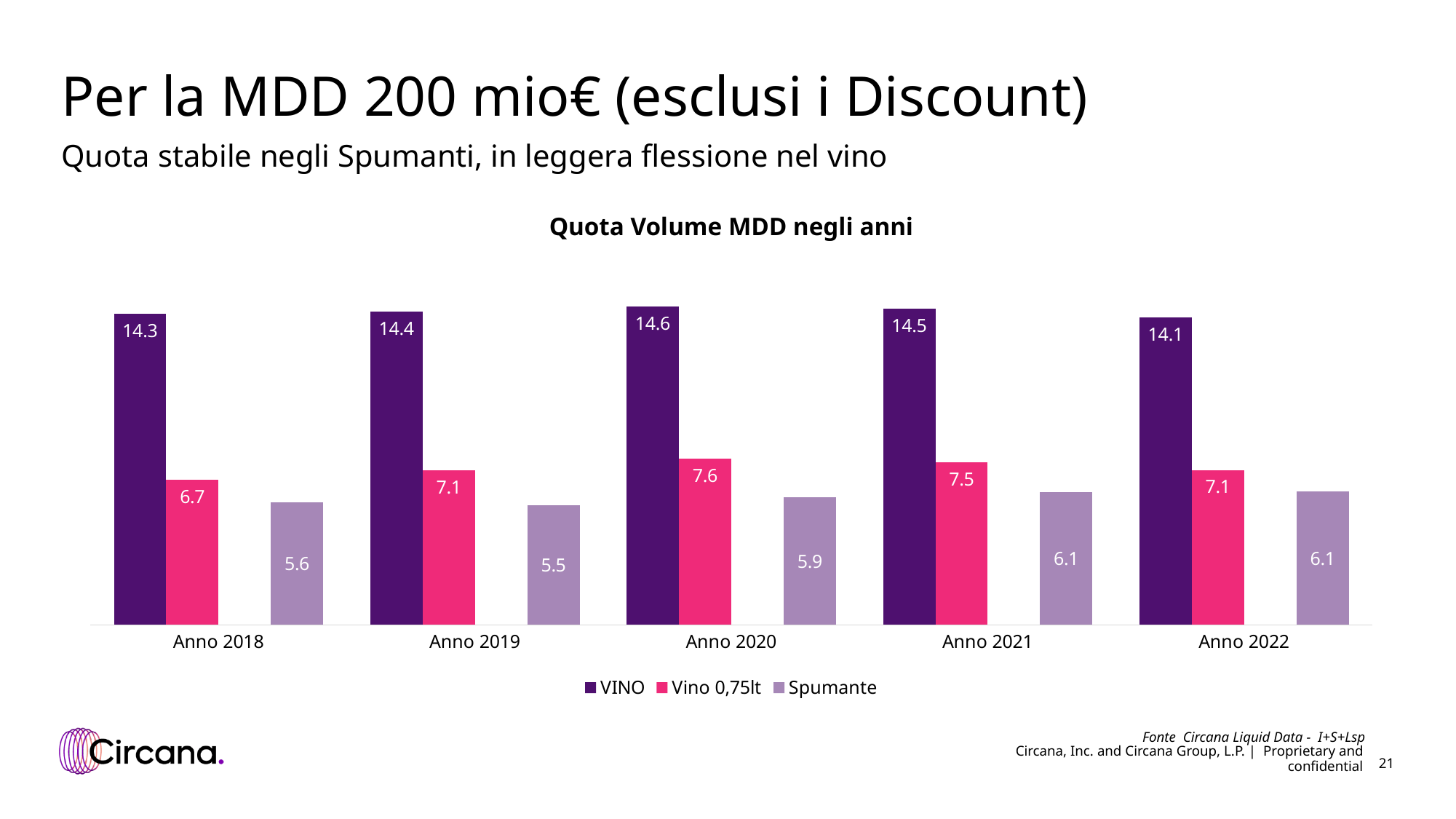
Does the VINO value rise or fall from Anno 2021 to Anno 2022? Fall How many series does the legend list? 3 What is the value for Spumante in Anno 2018? 5.6 In which year is the VINO value highest? Anno 2020 Which is larger, the Vino 0,75lt value in Anno 2018 or in Anno 2019? Anno 2019 What is the title of the chart? Quota Volume MDD negli anni In which year is the Spumante value lowest? Anno 2019 What is the difference between the VINO value in Anno 2020 and in Anno 2022? 0.5 What is the value for VINO in Anno 2020? 14.6 What kind of chart is shown on the slide? Bar chart What is the value for Vino 0,75lt in Anno 2021? 7.5 How many years are shown on the x axis? 5